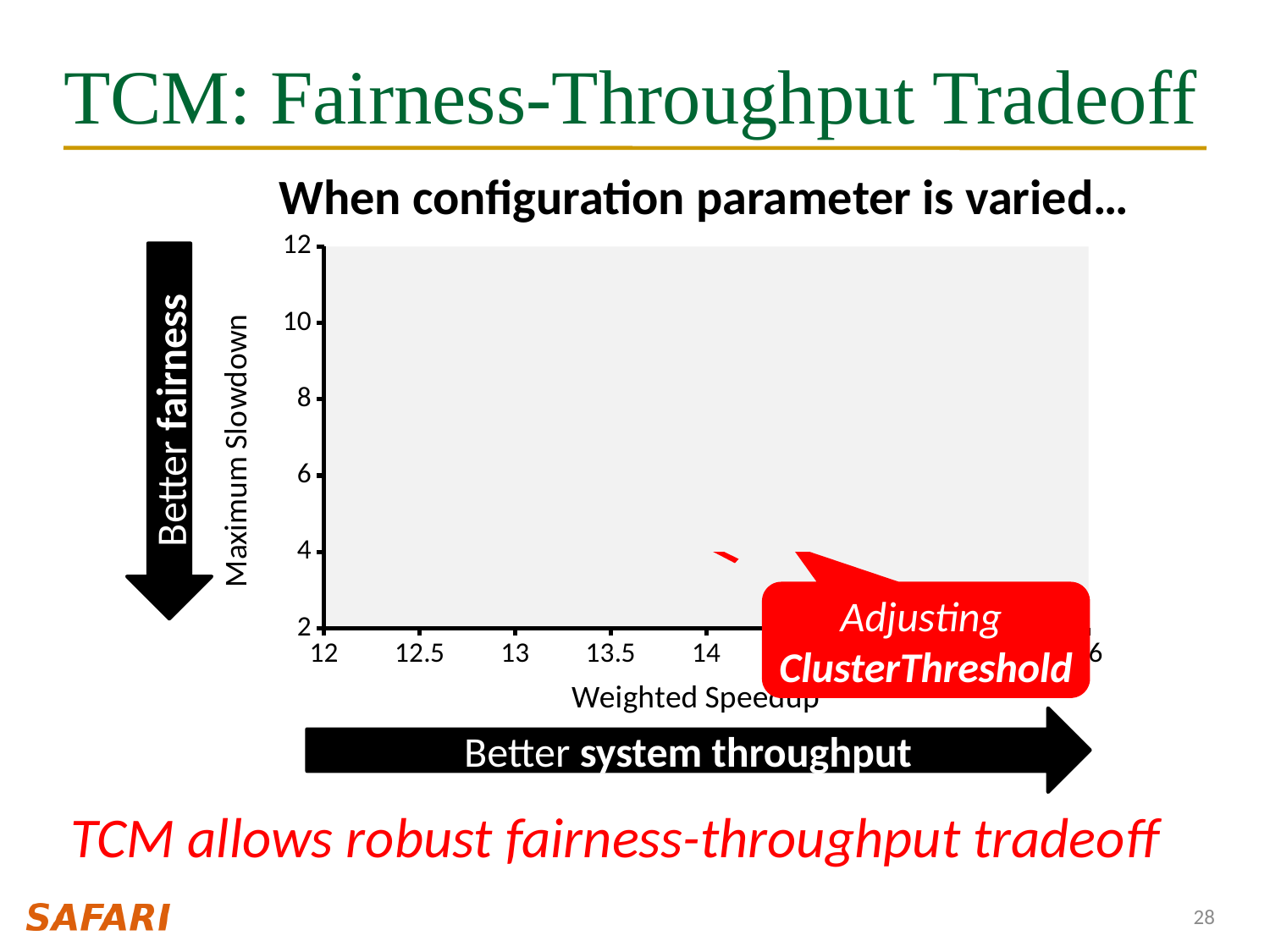
What is the title of the horizontal axis of the chart? Weighted Speedup What is the title of the vertical axis of the chart? Maximum Slowdown Is the Maximum Slowdown of the red data point visible near Weighted Speedup 14 greater or less than 6? less What kind of chart is shown on the slide? scatter chart Is the Weighted Speedup of the red data point visible in the chart greater or less than 13? greater